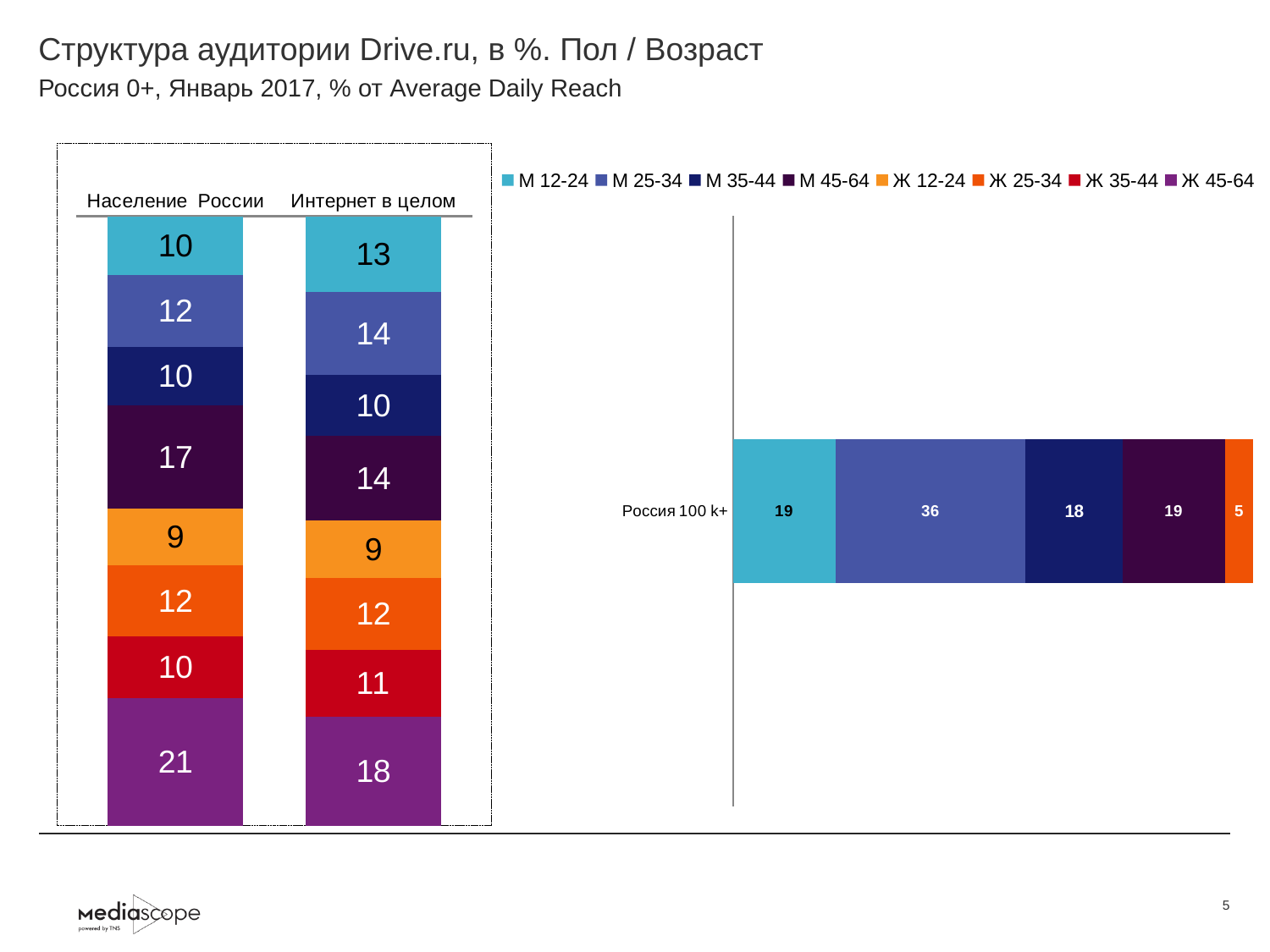
In the right chart, what is the value of the М 25-34 segment for Россия 100 k+? 36 In the left chart, what is the difference between the Ж 45-64 values for Население России and Интернет в целом? 3 In the left chart, which segment of the Население России bar has the smallest value? Ж 12-24 In the left chart, what is the value of the М 45-64 segment for Население России? 17 In the left chart, which is larger: the М 25-34 value for Население России or for Интернет в целом? Интернет в целом How many series does the legend list? 8 How many bars are shown in the left chart? 2 What type of chart is the right chart? Stacked bar chart In the right chart, what is the total of the labelled segments of the Россия 100 k+ bar? 97 In the right chart, which segment of the Россия 100 k+ bar has the largest value? М 25-34 In the left chart, what is the value of the М 12-24 segment for Интернет в целом? 13 In the left chart, what is the value of the Ж 45-64 segment for Население России? 21